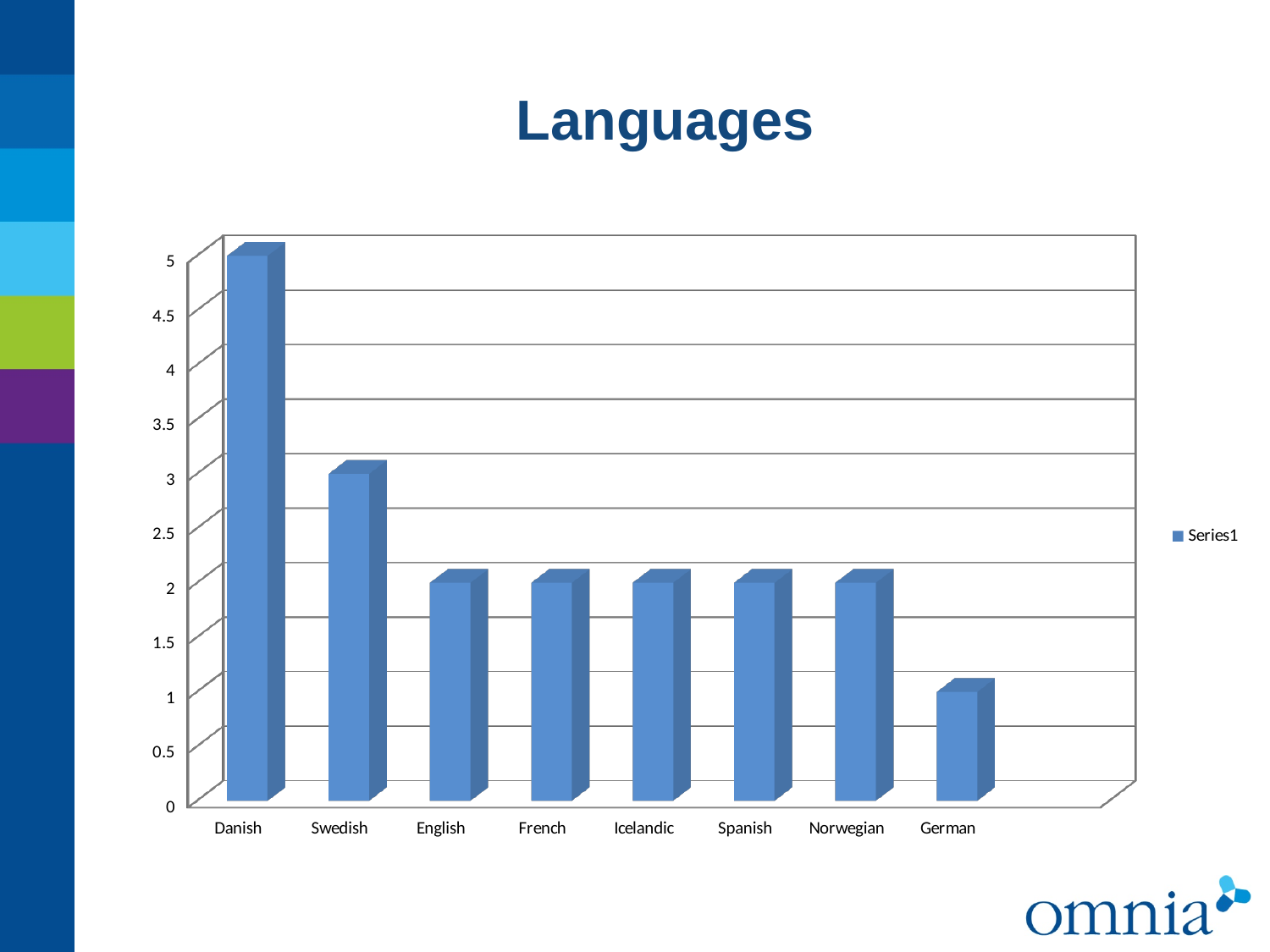
What is the difference between the values for Danish and Swedish? 2 How many languages are shown on the x axis? 8 What is the value for Swedish? 3 Which language has the highest value? Danish What is the value for German? 1 Which is larger, the value for Swedish or the value for Norwegian? Swedish What is the value for Icelandic? 2 What type of chart is shown on the slide? bar chart What is the title of the chart? Languages What is the value for Danish? 5 Which language has the lowest value? German How many series does the legend list? 1